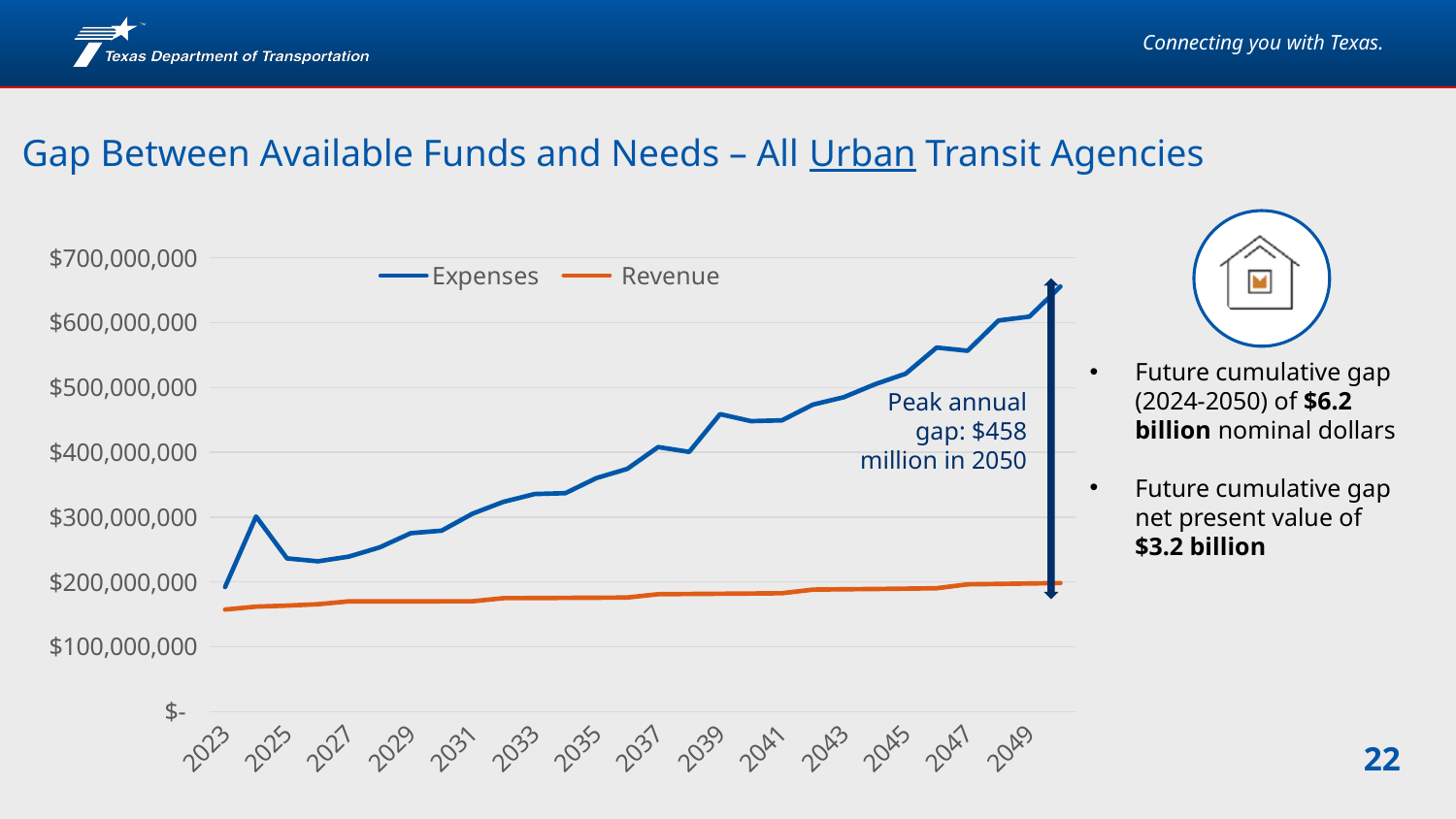
Does Revenue rise or fall overall from 2023 to 2050? rise Is the Revenue value for 2023 greater or less than $200,000,000? less What is the peak annual gap shown on the chart, and in which year does it occur? $458 million in 2050 Is the Expenses value for 2023 greater or less than $300,000,000? less What are the two series named in the chart legend? Expenses and Revenue Is the Expenses value for 2050 greater or less than $600,000,000? greater Do Expenses rise or fall overall from 2023 to 2050? rise How many series does the chart legend list? 2 Which series is drawn in blue? Expenses In 2050, which is larger, Expenses or Revenue? Expenses In which year do Expenses reach their highest value? 2050 What type of chart is shown on the slide? line chart